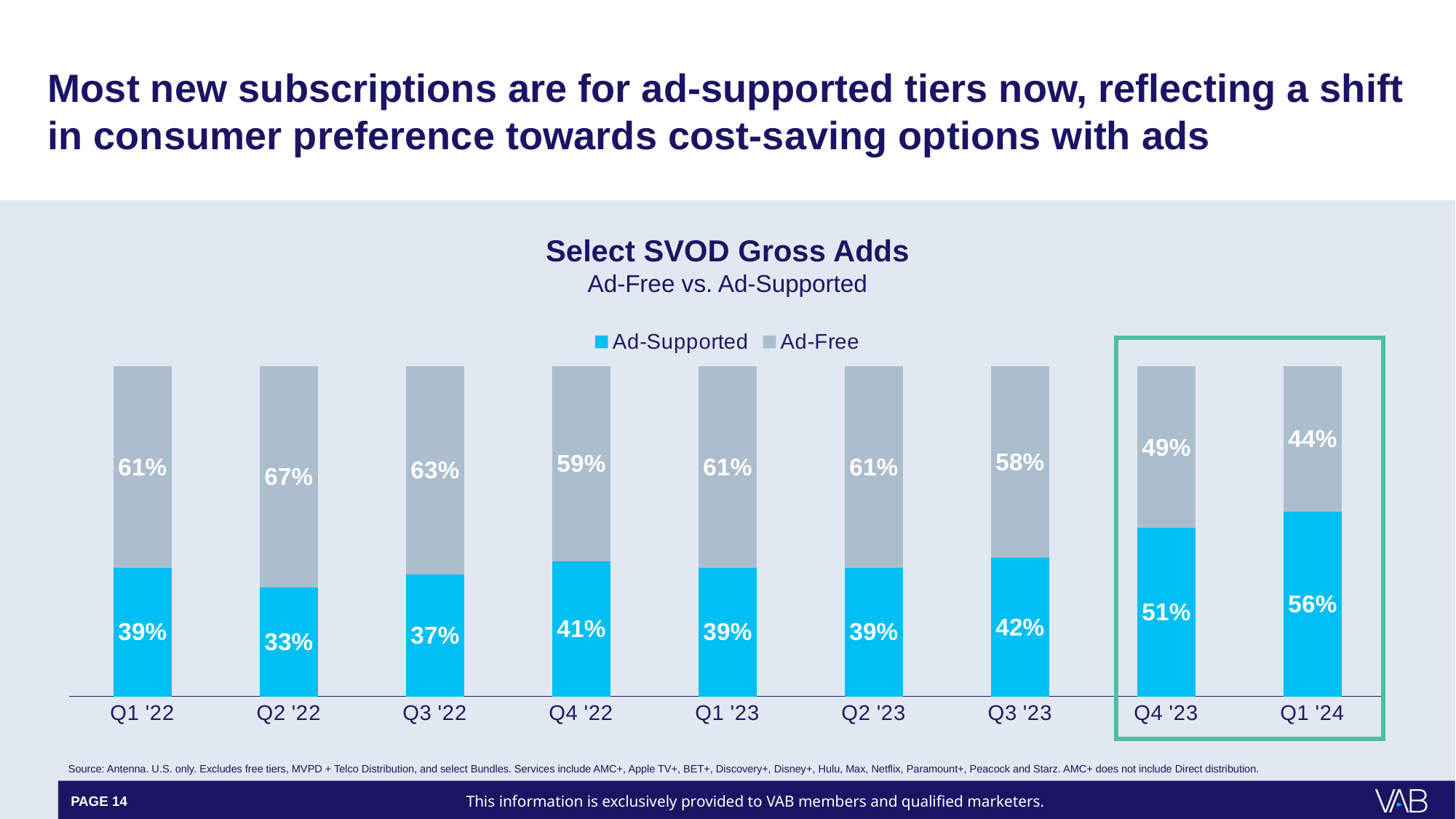
What is the difference between the Ad-Free and Ad-Supported shares in Q4 '23? 2 percentage points In which quarter is the Ad-Supported share lowest? Q2 '22 What is the Ad-Supported value for Q3 '23? 42% What is the Ad-Free share of gross adds in Q2 '22? 67% Does the Ad-Supported share rise or fall from Q3 '23 to Q1 '24? Rise How many quarters are shown on the x axis? 9 In which quarter is the Ad-Supported share highest? Q1 '24 Which is larger in Q1 '24, the Ad-Supported share or the Ad-Free share? Ad-Supported What is the Ad-Supported share of gross adds in Q1 '24? 56% What is the title of the chart? Select SVOD Gross Adds What kind of chart is shown on the slide? Stacked bar chart How many series does the legend list? 2